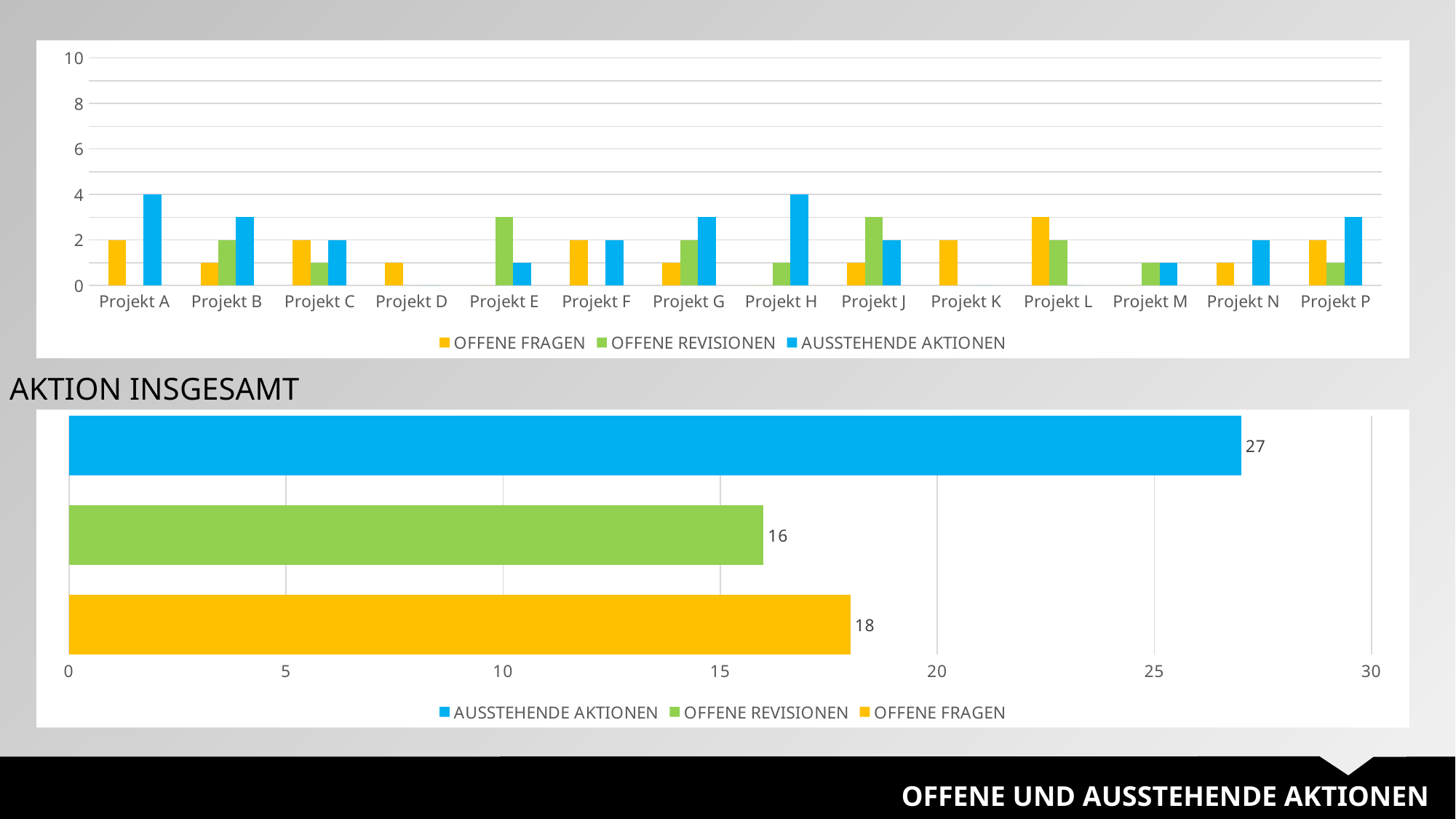
In the bottom chart titled AKTION INSGESAMT, which is larger: OFFENE FRAGEN or OFFENE REVISIONEN? OFFENE FRAGEN In the bottom chart titled AKTION INSGESAMT, how many bars are plotted? 3 In the bottom chart titled AKTION INSGESAMT, what is the value for OFFENE REVISIONEN? 16 In the bottom chart titled AKTION INSGESAMT, which category has the highest value? AUSSTEHENDE AKTIONEN In the bottom chart titled AKTION INSGESAMT, which category has the lowest value? OFFENE REVISIONEN In the bottom chart titled AKTION INSGESAMT, what is the difference between AUSSTEHENDE AKTIONEN and OFFENE REVISIONEN? 11 In the top chart, how many series does the legend list? 3 In the bottom chart titled AKTION INSGESAMT, what is the value for OFFENE FRAGEN? 18 What kind of chart is the bottom chart titled AKTION INSGESAMT? Bar chart In the top chart, how many projects are shown on the x axis? 14 In the top chart, what is the value of AUSSTEHENDE AKTIONEN for Projekt A? 4 In the bottom chart titled AKTION INSGESAMT, what is the value for AUSSTEHENDE AKTIONEN? 27